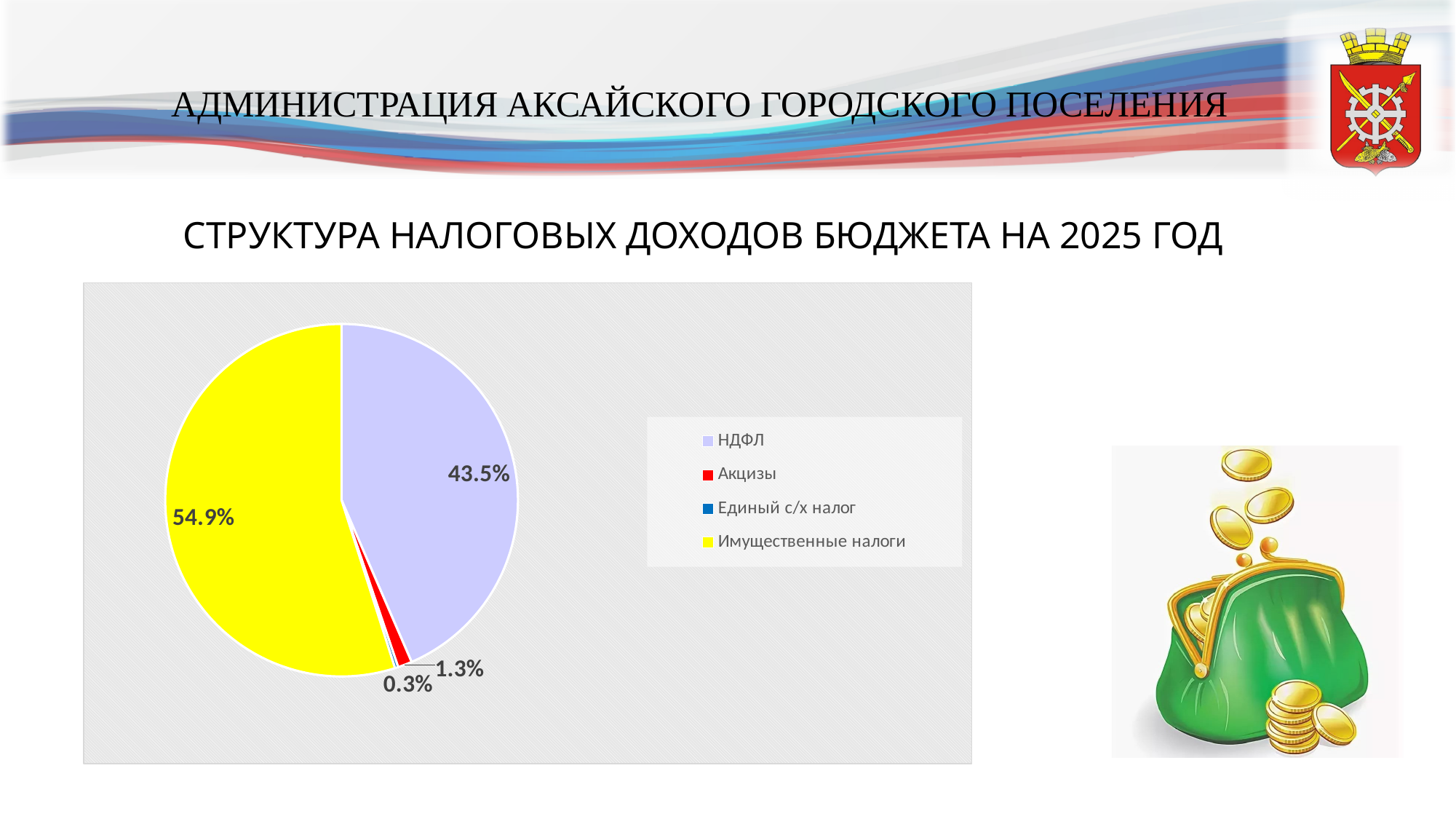
What share of the pie does Акцизы have? 1.3% What colour is the slice for Имущественные налоги? yellow How many categories does the pie chart show? 4 What share of the pie does НДФЛ have? 43.5% What share of the pie does Единый с/х налог have? 0.3% What share of the pie does Имущественные налоги have? 54.9% Which is larger, the share of Акцизы or the share of Единый с/х налог? Акцизы Which category has the largest slice of the pie? Имущественные налоги What is the difference between the shares of Имущественные налоги and НДФЛ? 11.4% What kind of chart is shown on the slide? pie chart Which category has the smallest slice of the pie? Единый с/х налог What is the title of the chart on the slide? СТРУКТУРА НАЛОГОВЫХ ДОХОДОВ БЮДЖЕТА НА 2025 ГОД